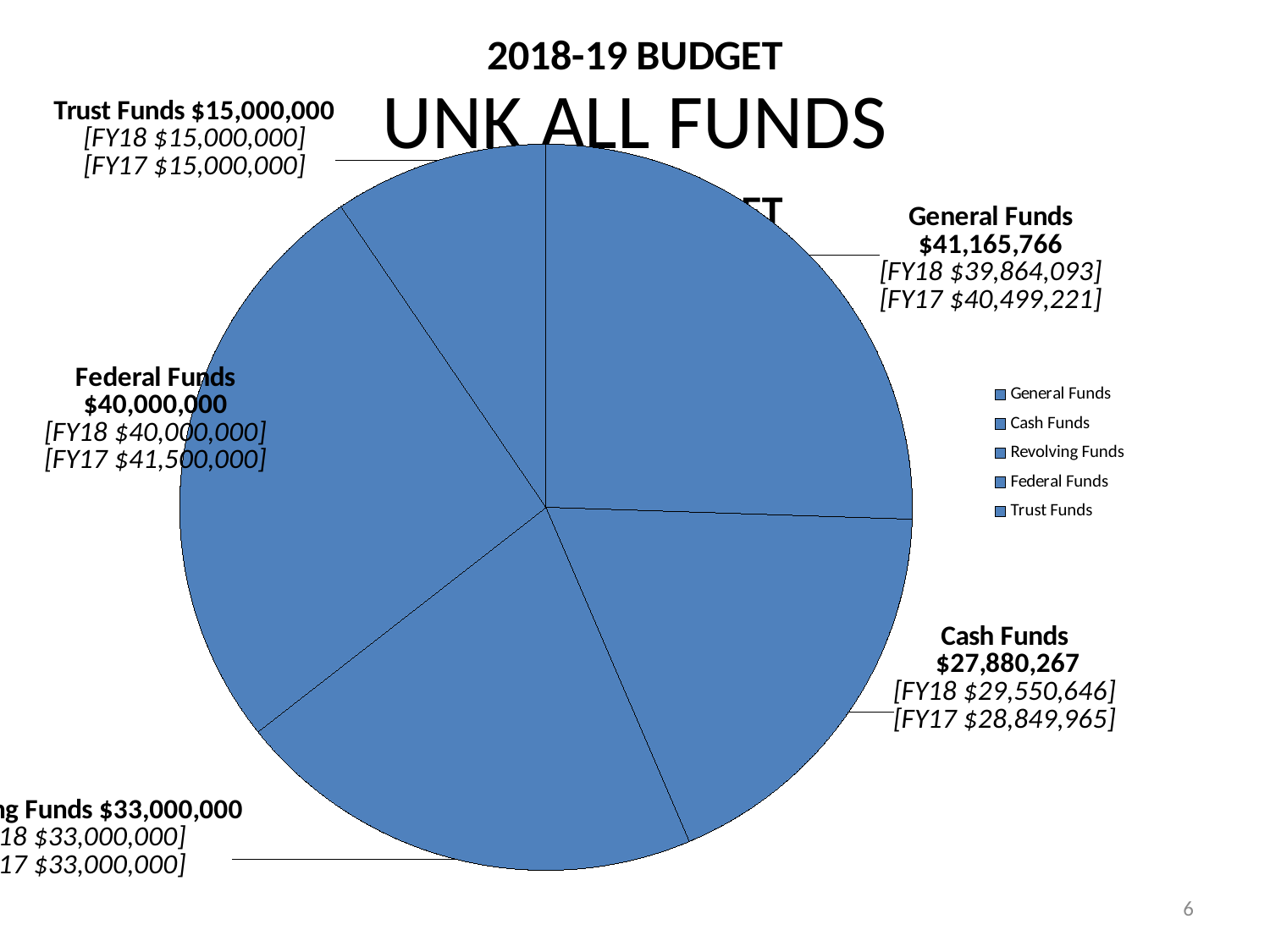
Which is larger in 2018-19, Cash Funds or Revolving Funds? Revolving Funds What is the 2018-19 value for Cash Funds? $27,880,267 What kind of chart is shown on the slide? Pie chart What is the 2018-19 value for General Funds? $41,165,766 What is the difference between the 2018-19 Federal Funds and Revolving Funds values? $7,000,000 Which fund category has the largest 2018-19 value? General Funds What is the 2018-19 value for Federal Funds? $40,000,000 What is the FY17 value shown for Cash Funds? $28,849,965 Which fund category has the smallest 2018-19 value? Trust Funds What is the FY18 value shown for General Funds? $39,864,093 How many slices does the pie chart have? 5 What is the difference between the 2018-19 General Funds and Federal Funds values? $1,165,766